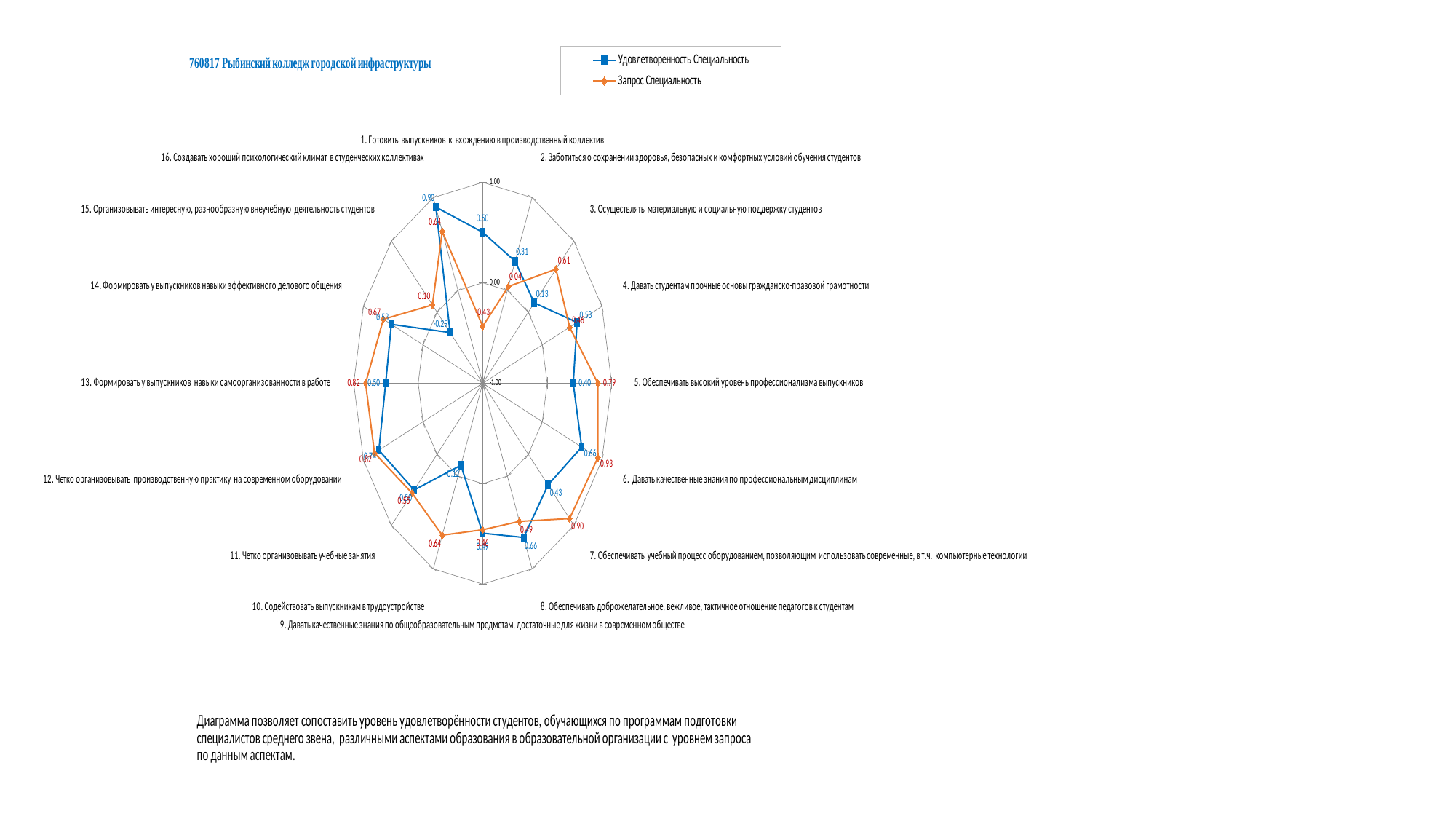
Which category has the highest value for the 'Запрос Специальность' series? 6. Давать качественные знания по профессиональным дисциплинам How many categories (axes) does the radar chart have? 16 What is the value of 'Запрос Специальность' for category 13 (Формировать у выпускников навыки самоорганизованности в работе)? 0.82 What type of chart is shown on the slide? Radar chart How many series does the legend list? 2 Which category has the lowest value for the 'Удовлетворенность Специальность' series? 15. Организовывать интересную, разнообразную внеучебную деятельность студентов Which category has the highest value for the 'Удовлетворенность Специальность' series? 16. Создавать хороший психологический климат в студенческих коллективах What is the value of 'Запрос Специальность' for category 6 (Давать качественные знания по профессиональным дисциплинам)? 0.93 What is the value of 'Удовлетворенность Специальность' for category 5 (Обеспечивать высокий уровень профессионализма выпускников)? 0.40 What is the value of 'Удовлетворенность Специальность' for category 16 (Создавать хороший психологический климат в студенческих коллективах)? 0.90 For category 5 (Обеспечивать высокий уровень профессионализма выпускников), what is the difference between 'Запрос Специальность' and 'Удовлетворенность Специальность'? 0.39 For category 16, which series has the larger value: 'Удовлетворенность Специальность' or 'Запрос Специальность'? Удовлетворенность Специальность